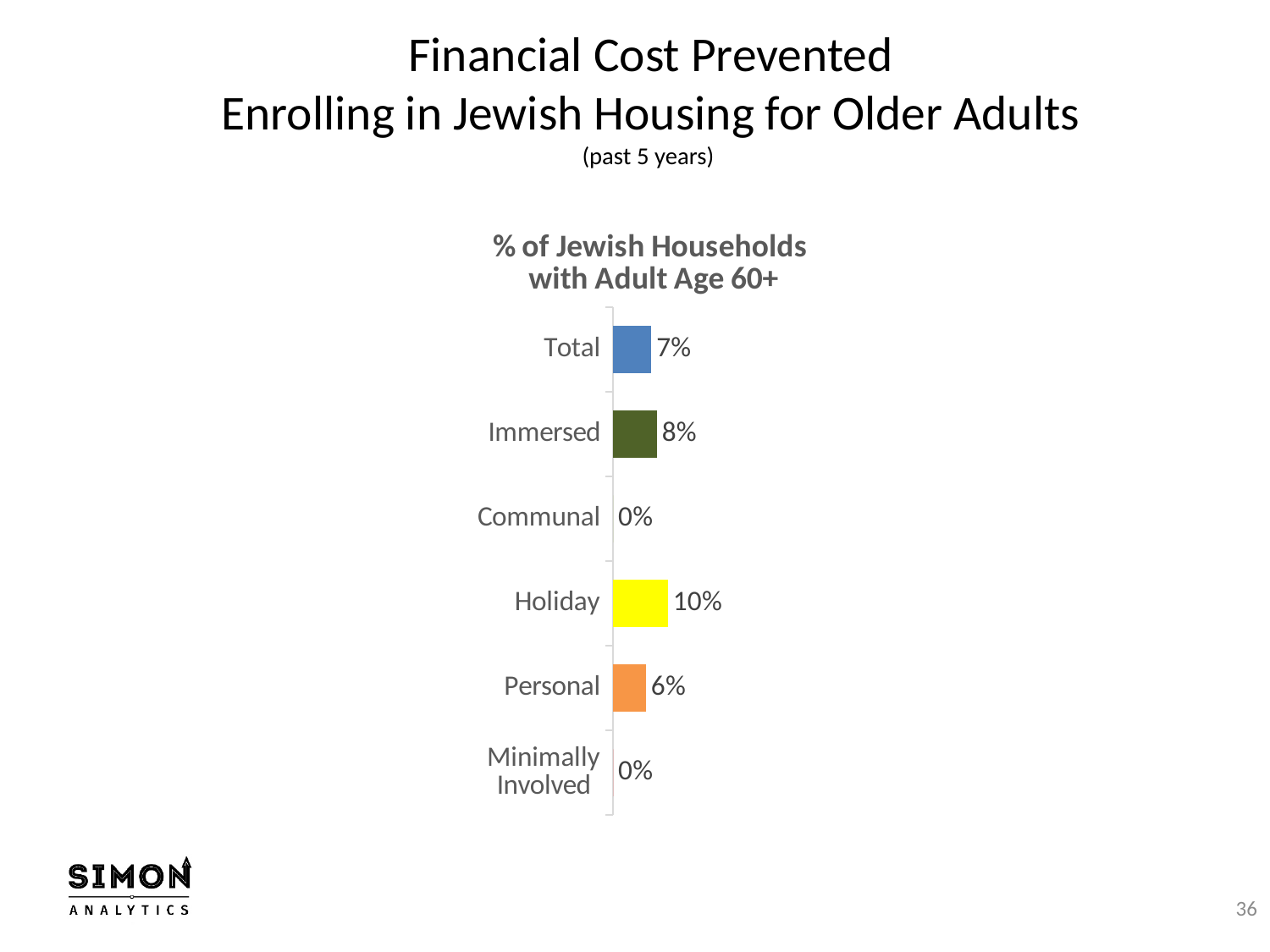
What is the value for Personal? 6% What kind of chart is shown on the slide? Bar chart What is the value for Communal? 0% What is the value for Holiday? 10% What is the title of the chart? % of Jewish Households with Adult Age 60+ What is the value for Immersed? 8% Which category has the highest value? Holiday What is the value for Total? 7% What is the difference between the values for Holiday and Personal? 4% What is the difference between the values for Immersed and Total? 1% Which is larger, the value for Immersed or the value for Personal? Immersed How many categories are shown in the chart? 6